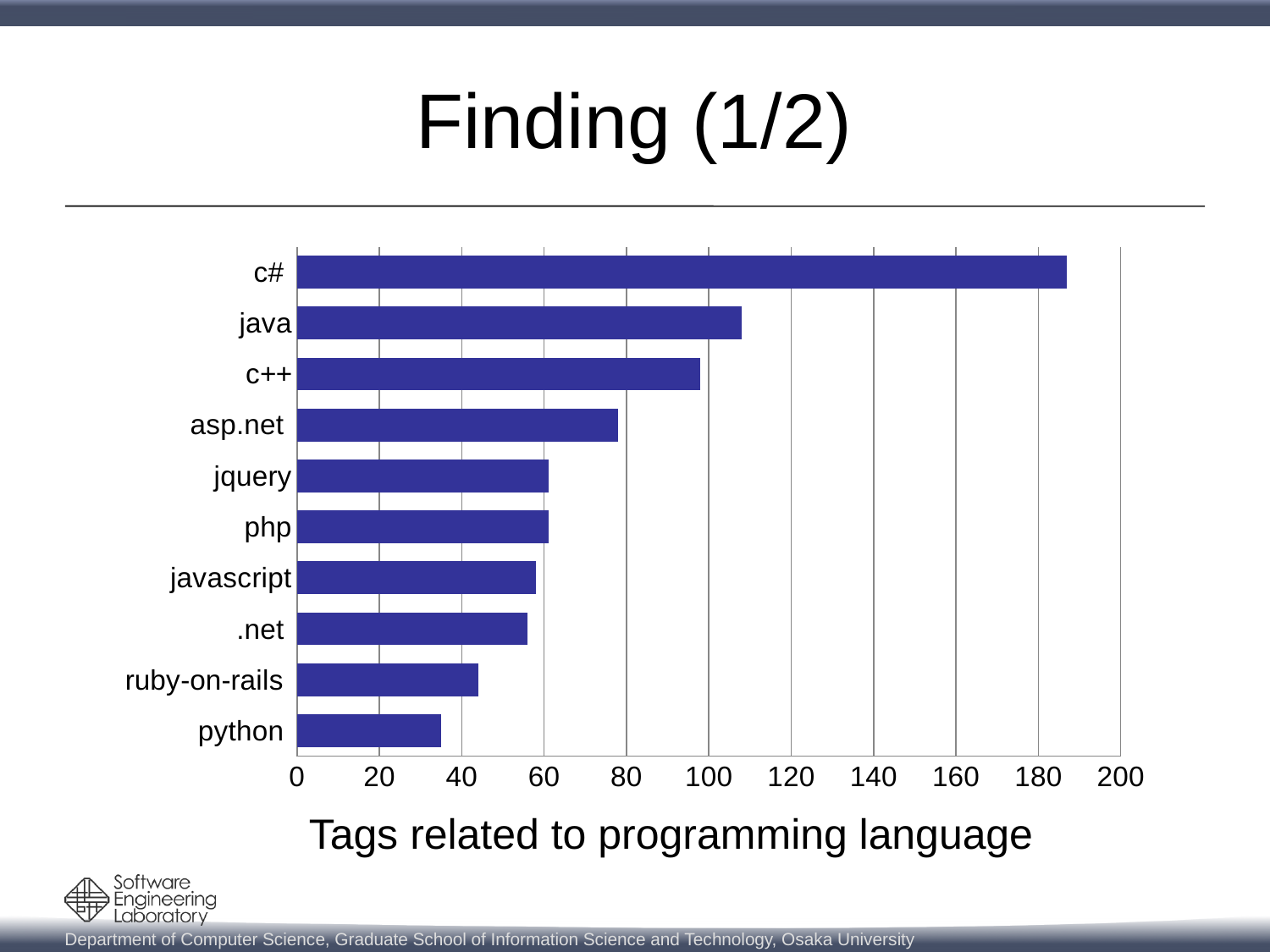
Is the value for asp.net greater or less than 80? less Is the value for java greater or less than 100? greater Which has a larger value, asp.net or ruby-on-rails? asp.net Is the value for c++ greater or less than 100? less How many programming language tags are shown in the chart? 10 Which tag has the highest value in the chart? c# Which tag has the lowest value in the chart? python Which has a larger value, c# or java? c# What is the caption shown below the chart? Tags related to programming language What kind of chart is shown on the slide? bar chart